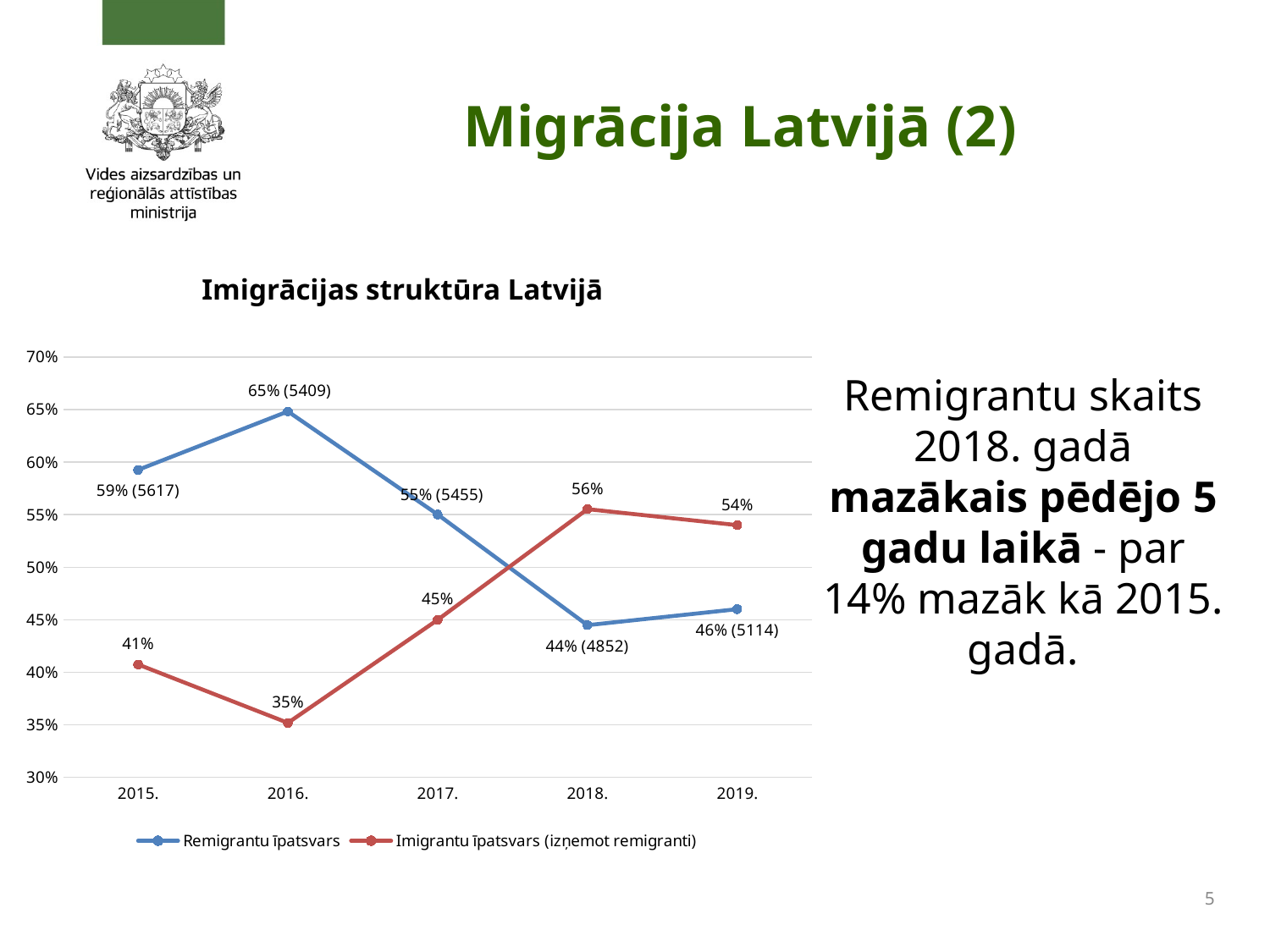
What is the difference in percentage points between Remigrantu īpatsvars and Imigrantu īpatsvars (izņemot remigranti) in 2015? 18 How many years are shown on the x axis? 5 Does Imigrantu īpatsvars (izņemot remigranti) rise or fall from 2016 to 2018? rise What is the value of Remigrantu īpatsvars in 2016? 65% (5409) What is the value of Remigrantu īpatsvars in 2018? 44% (4852) Which series has the larger value in 2019, Remigrantu īpatsvars or Imigrantu īpatsvars (izņemot remigranti)? Imigrantu īpatsvars (izņemot remigranti) What is the title of the chart? Imigrācijas struktūra Latvijā What type of chart is shown on the slide? line chart What is the value of Imigrantu īpatsvars (izņemot remigranti) in 2018? 56% In which year is Imigrantu īpatsvars (izņemot remigranti) lowest? 2016. In which year is Remigrantu īpatsvars highest? 2016. How many series does the legend list? 2